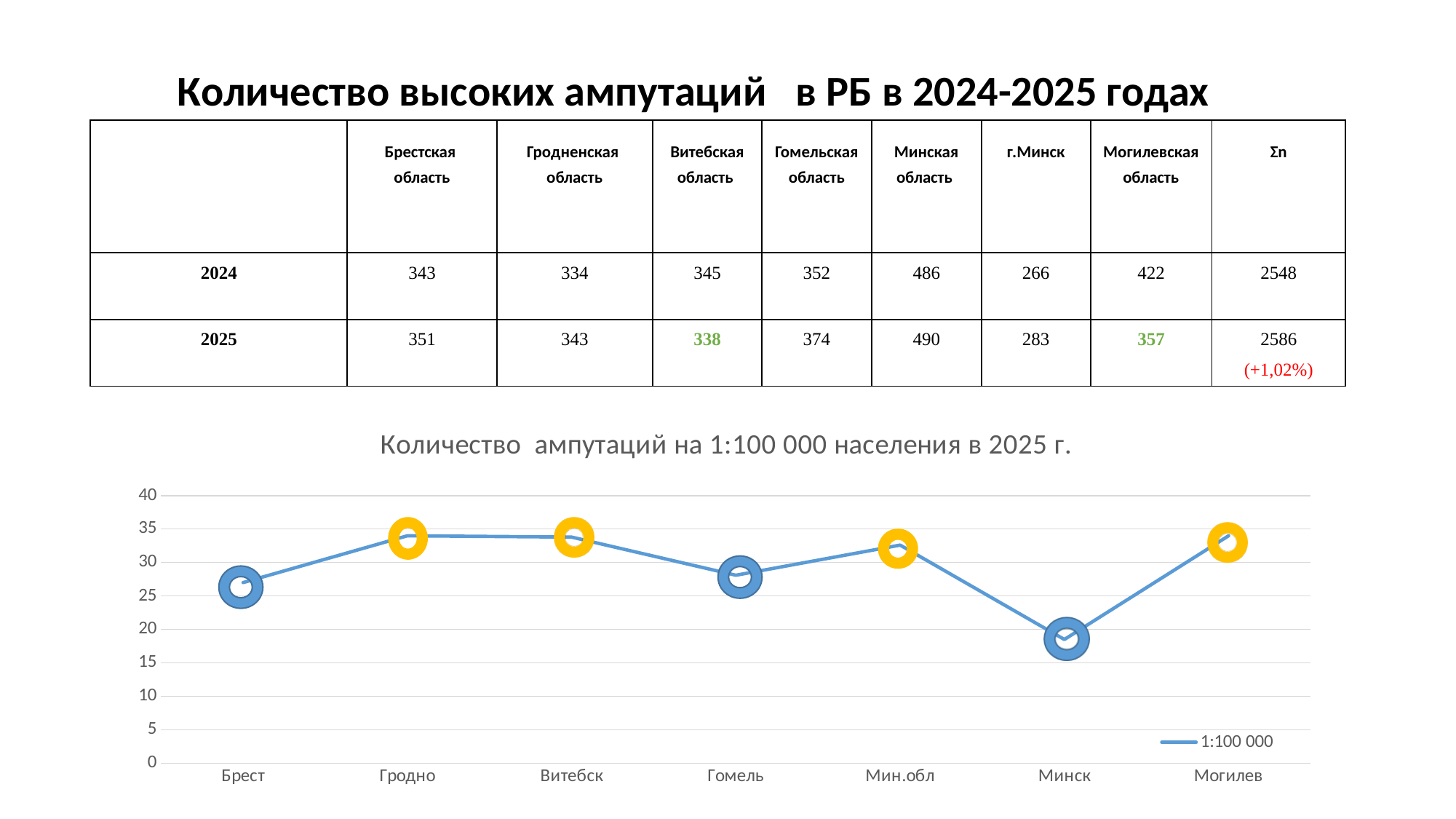
What is the title of the chart? Количество ампутаций на 1:100 000 населения в 2025 г. Is the value for Могилев greater or less than 30? greater Does the line rise or fall from Мин.обл to Минск? fall Is the value for Минск greater or less than 20? less What kind of chart is shown on the slide? line chart Which has the larger value, Могилев or Гомель? Могилев Is the value for Брест greater or less than 30? less How many cities/regions are plotted along the x axis of the chart? 7 Which has the larger value, Брест or Минск? Брест How many series does the chart legend list? 1 Which category has the lowest value in the chart? Минск